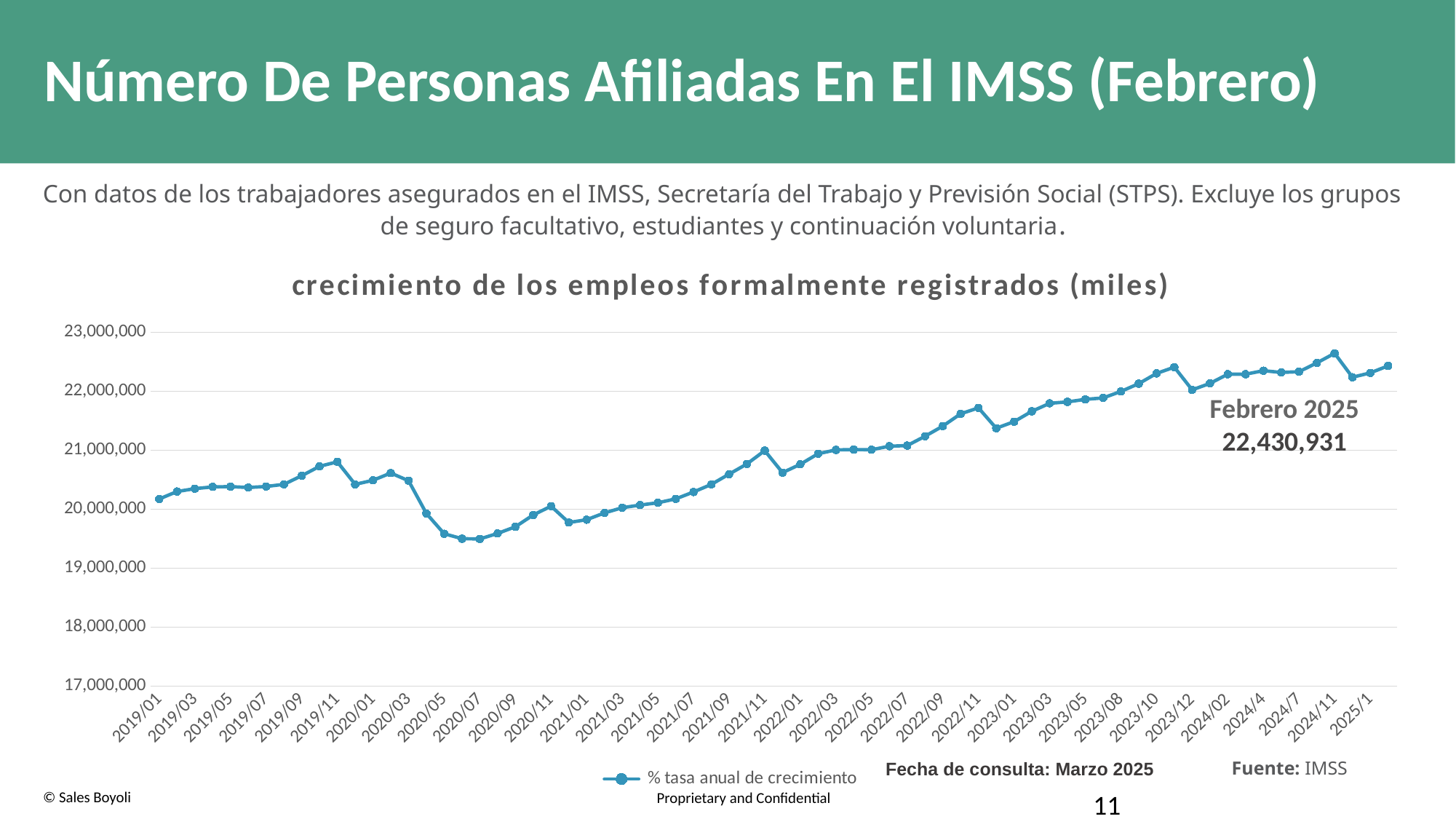
What value is labelled for Febrero 2025? 22,430,931 What is the legend entry for the plotted series? % tasa anual de crecimiento How many series does the legend list? 1 Is the value for 2019/01 greater or less than 21,000,000? less What kind of chart is shown on the slide? line chart Is the value for 2024/11 greater or less than 22,000,000? greater What is the title of the chart? crecimiento de los empleos formalmente registrados (miles) Which is larger, the value for 2023/10 or the value for 2023/12? 2023/10 Which x-axis label has the highest value on the line? 2024/11 Which is larger, the value for 2019/11 or the value for 2020/07? 2019/11 Overall, do the values rise or fall from 2019/01 to 2025/1? rise Is the value for 2020/07 greater or less than 20,000,000? less